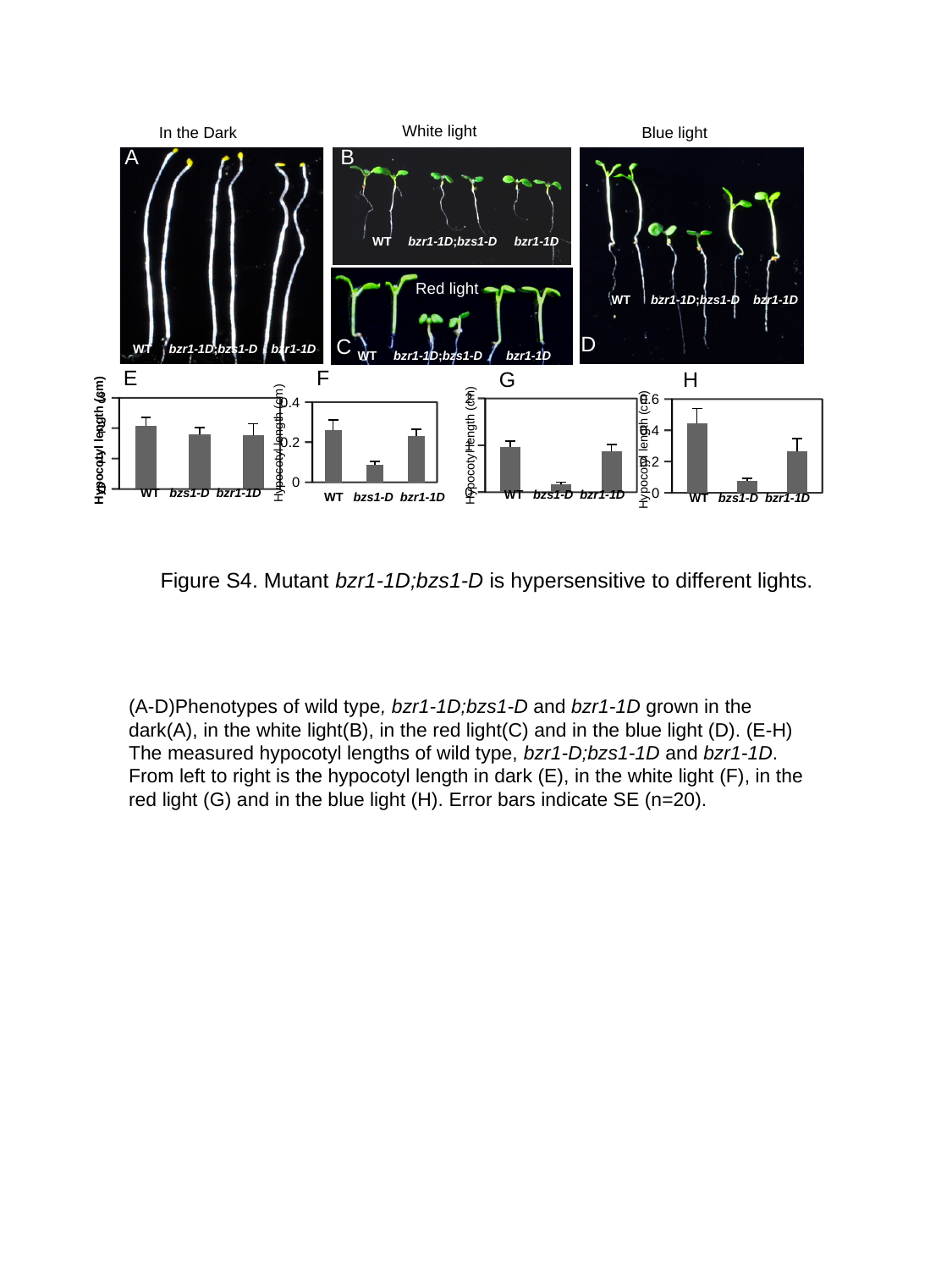
How many categories are shown in chart E (dark)? 3 In chart H (blue light), which is larger, the value for WT or the value for bzr1-1D? WT In chart H (blue light), which category has the lowest hypocotyl length? bzs1-D In chart E (dark), which category has the highest hypocotyl length? WT In chart H (blue light), is the value for bzs1-D greater or less than 0.2? less In chart H (blue light), is the value for WT greater or less than 0.4? greater In chart H (blue light), is the value for bzr1-1D greater or less than 0.2? greater In chart F (white light), which category has the lowest hypocotyl length? bzs1-D In chart G (red light), which category has the lowest hypocotyl length? bzs1-D In chart H (blue light), which category has the highest hypocotyl length? WT What kind of chart is chart H (blue light)? bar chart